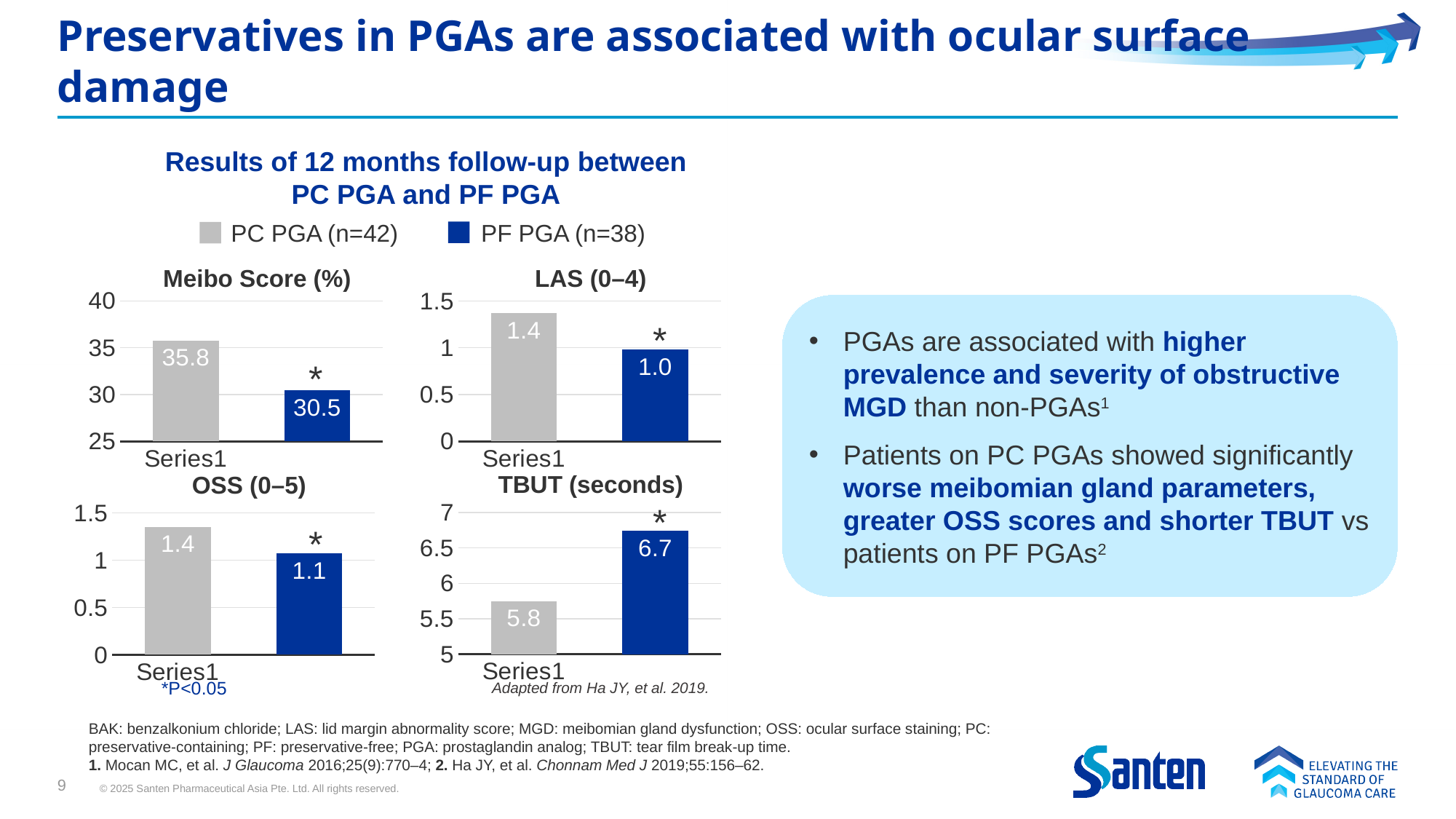
In the Meibo Score (%) chart, what is the difference between the PC PGA and PF PGA values? 5.3 In the TBUT (seconds) chart, what is the value for PC PGA? 5.8 In the OSS (0–5) chart, which group has the lower value? PF PGA In the Meibo Score (%) chart, what is the value for PF PGA? 30.5 How many series does the legend list? 2 In the TBUT (seconds) chart, what is the difference between the PF PGA and PC PGA values? 0.9 What kind of chart is the LAS (0–4) chart? Bar chart In the LAS (0–4) chart, what is the value for PF PGA? 1.0 In the TBUT (seconds) chart, which group has the higher value, PC PGA or PF PGA? PF PGA According to the legend, how many patients were in the PF PGA group? 38 In the OSS (0–5) chart, what is the value for PC PGA? 1.4 In the Meibo Score (%) chart, what is the value for PC PGA? 35.8